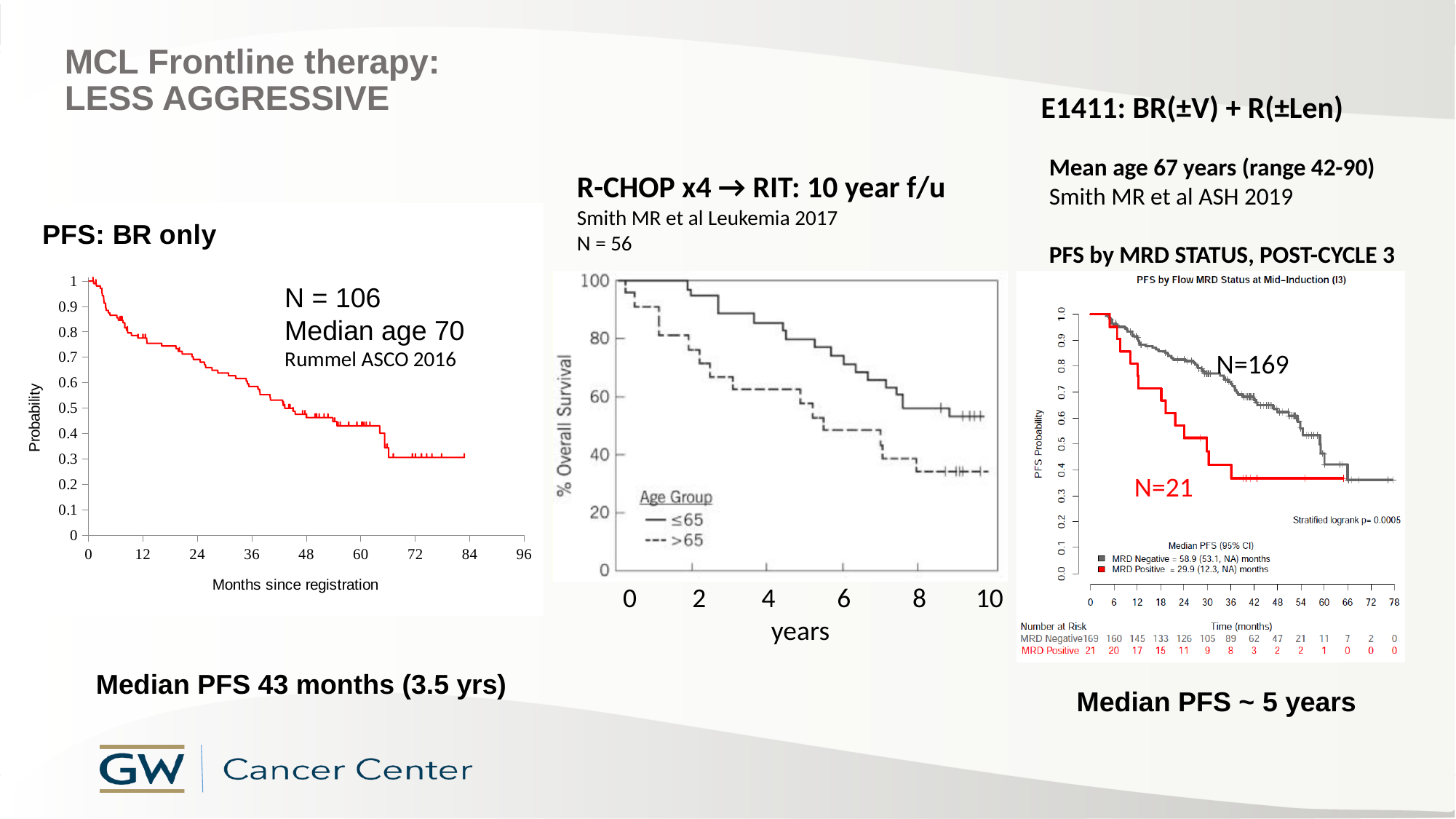
In the 'PFS: BR only' chart, is the probability at 72 months greater or less than 0.4? less In the 'R-CHOP x4 → RIT' chart, is the overall survival for the >65 group at 10 years greater or less than 40%? less In the 'PFS: BR only' chart, is the probability at 12 months greater or less than 0.7? greater How many series does the legend of the 'R-CHOP x4 → RIT' chart list? 2 In the 'R-CHOP x4 → RIT' chart, which age group has the higher overall survival at 10 years, ≤65 or >65? ≤65 In the 'PFS by MRD STATUS, POST-CYCLE 3' chart, what is the median PFS for the MRD Negative group? 58.9 months In the 'PFS: BR only' chart, does the probability rise or fall as months since registration increase? fall In the 'PFS by MRD STATUS, POST-CYCLE 3' chart, what is the median PFS for the MRD Positive group? 29.9 months In the 'PFS by MRD STATUS, POST-CYCLE 3' chart, how many MRD Negative patients were at risk at 36 months? 89 What is the median PFS reported for the 'PFS: BR only' chart? 43 months (3.5 yrs) What kind of chart is the 'PFS: BR only' chart on the left? line chart (Kaplan-Meier survival curve) In the 'PFS by MRD STATUS, POST-CYCLE 3' chart, what is the difference in median PFS between the MRD Negative and MRD Positive groups? 29.0 months